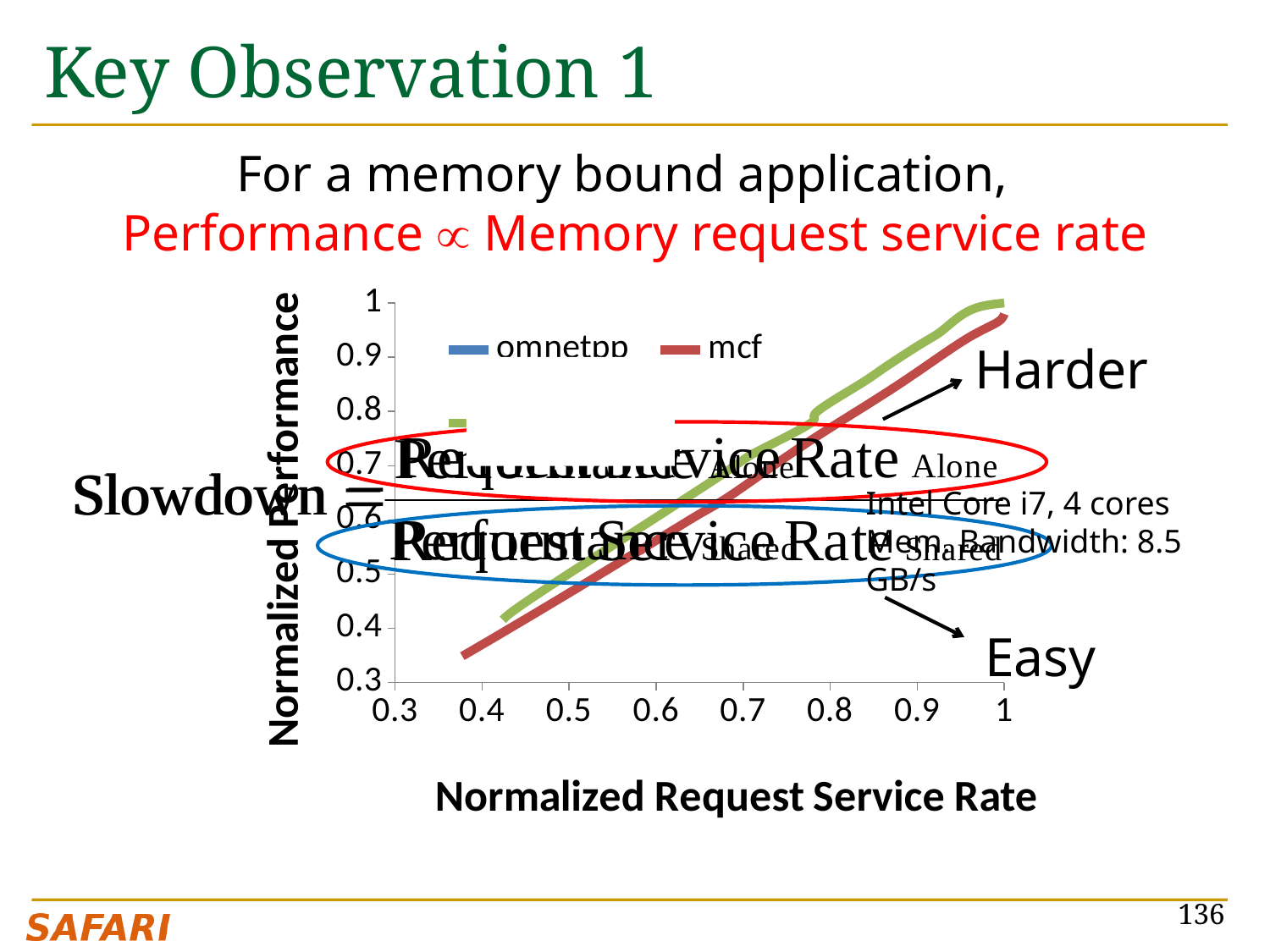
Is the normalized performance of mcf at a normalized request service rate of 1 greater or less than 0.9? greater Do the plotted values for mcf rise or fall as the normalized request service rate increases? rise Which two series are listed in the chart legend? omnetpp and mcf Is the normalized performance of mcf at a normalized request service rate of 0.4 greater or less than 0.5? less How many tick labels are shown on the chart's x axis? 8 What kind of chart is shown on the slide? line chart What is the title of the chart's x axis? Normalized Request Service Rate How many series does the chart legend list? 2